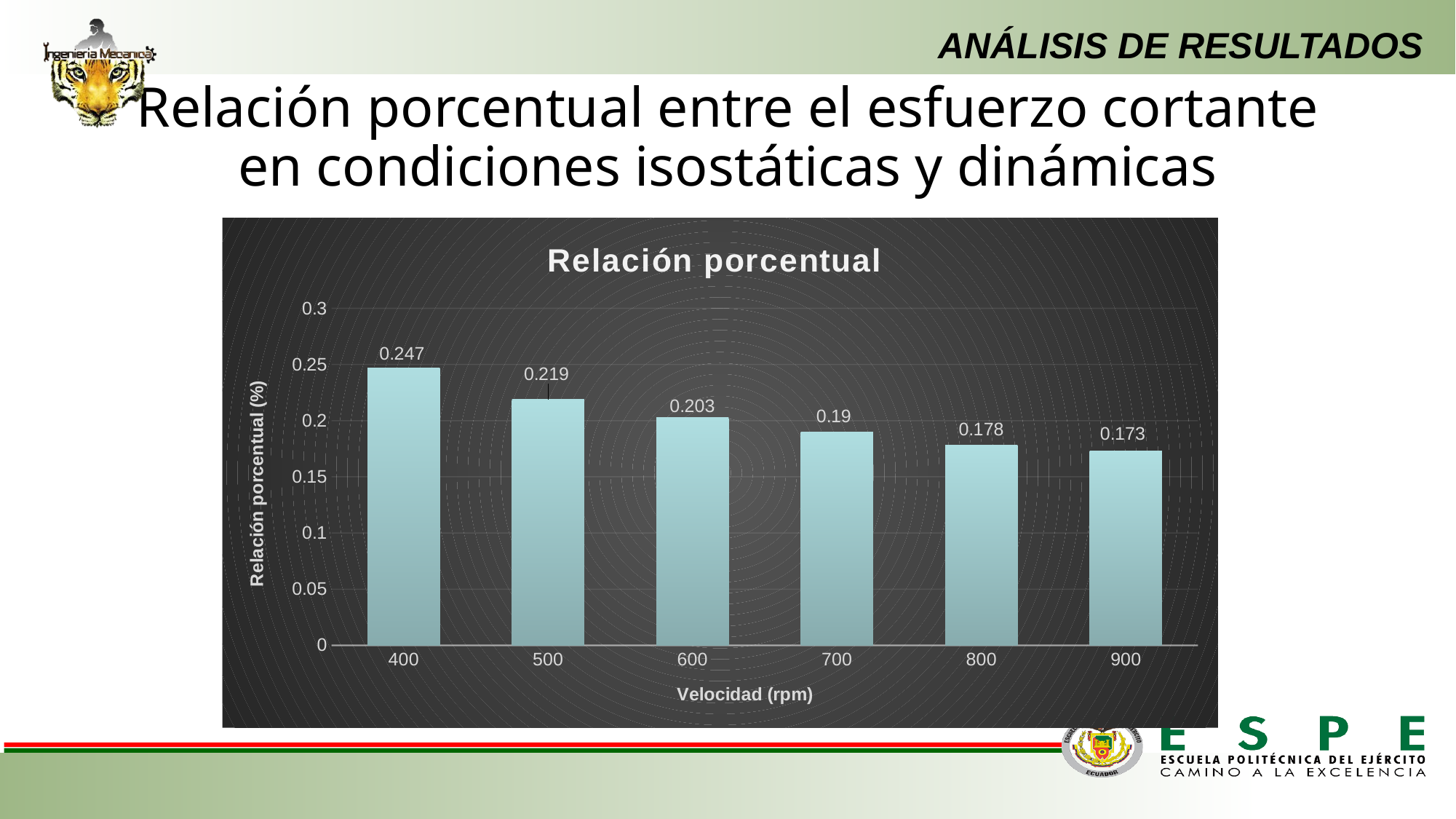
What is the difference between the values for 400 rpm and 500 rpm? 0.028 How many speed categories are shown on the x axis? 6 What kind of chart is shown? bar chart What is the value for 900 rpm? 0.173 What is the value for 700 rpm? 0.19 Do the values rise or fall as speed increases along the x axis? fall What is the value for 400 rpm? 0.247 What is the title of the chart? Relación porcentual Which speed has the highest relación porcentual? 400 Which speed has the lowest relación porcentual? 900 Which is larger, the value for 600 rpm or the value for 800 rpm? 600 rpm Is the value for 500 rpm greater or less than 0.2? greater